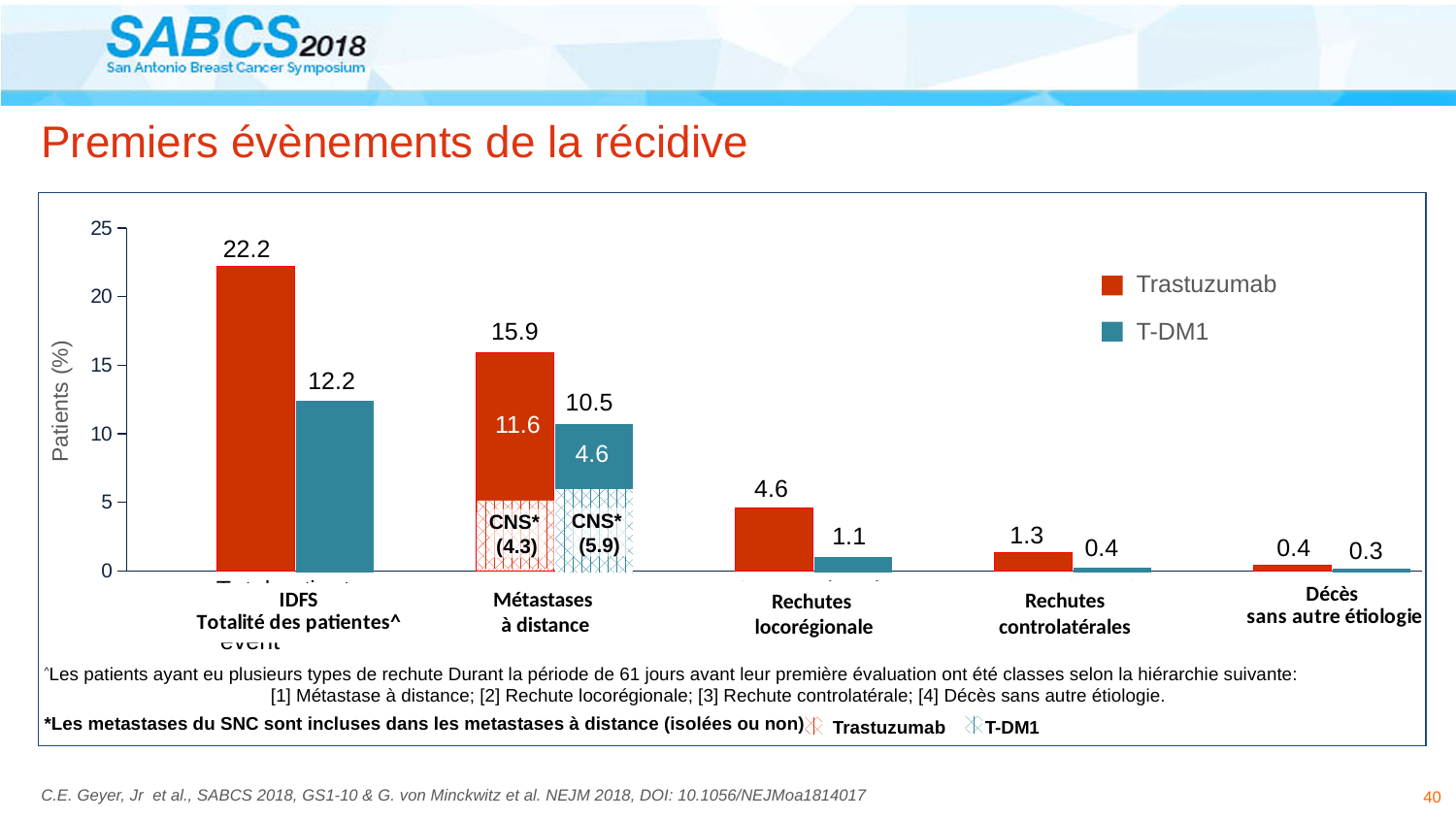
What is the value for T-DM1 in the IDFS (Totalité des patientes) category? 12.2 What is the value for Trastuzumab in the IDFS (Totalité des patientes) category? 22.2 Which category has the highest value for Trastuzumab? IDFS Totalité des patientes^ How many series does the legend list? 2 What is the CNS value shown for T-DM1 in the Métastases à distance category? 5.9 What is the value for T-DM1 in the Métastases à distance category? 10.5 How many categories are shown on the x axis? 5 What is the value for Trastuzumab in the Rechutes locorégionale category? 4.6 What kind of chart is shown on the slide? Bar chart Which category has the lowest value for T-DM1? Décès sans autre étiologie Which is larger in the Rechutes controlatérales category, Trastuzumab or T-DM1? Trastuzumab What is the difference between the Trastuzumab and T-DM1 values in the IDFS (Totalité des patientes) category? 10.0